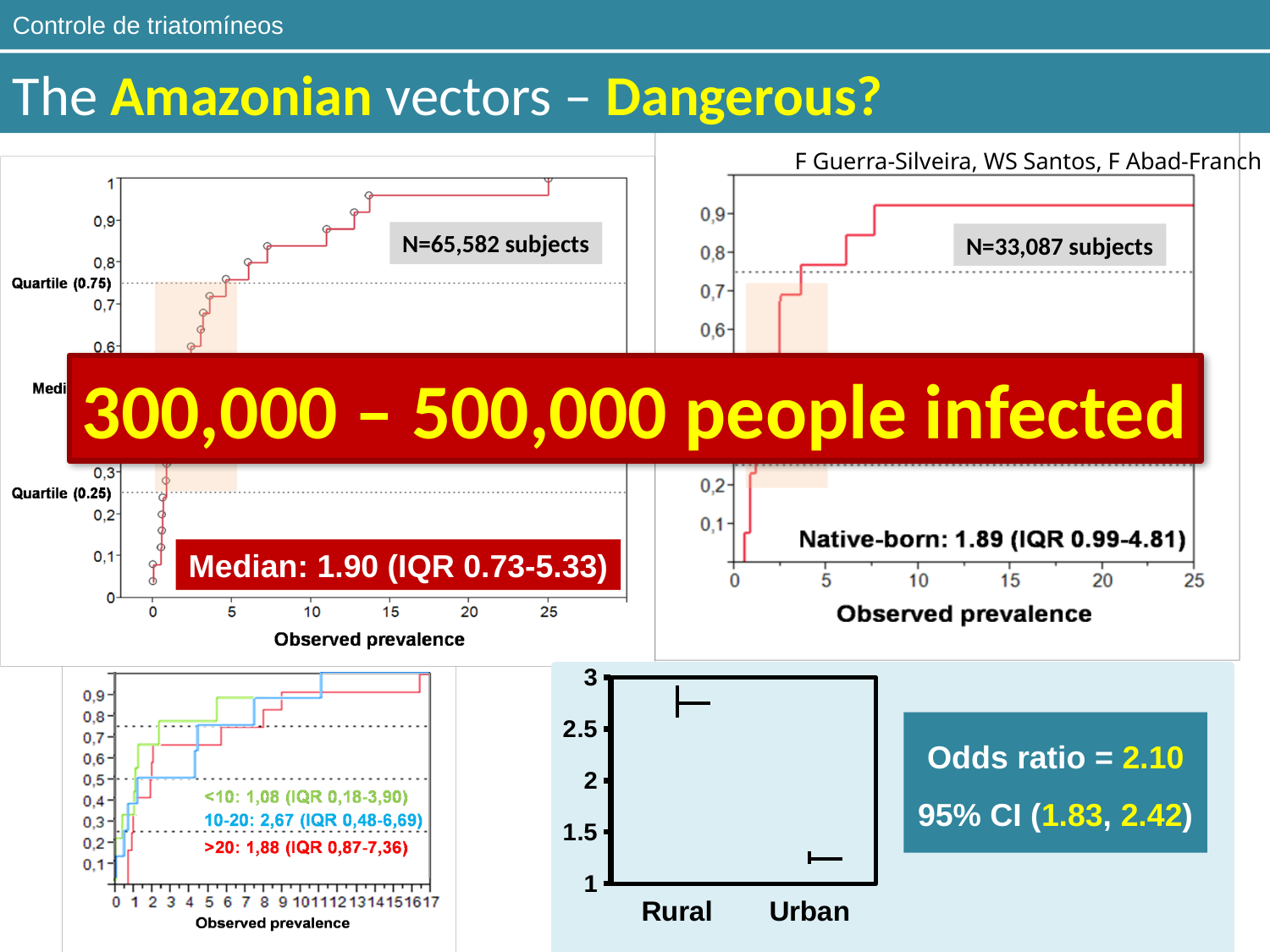
What is the odds ratio reported next to the bottom-right chart? 2.10 In the bottom-right chart, is the value for Rural greater or less than 2.5? greater In the bottom-left chart, how many groups (series) are labelled? 3 In the top-left chart, what is the median observed prevalence reported? 1.90 (IQR 0.73-5.33) In the bottom-right chart, is the value for Urban greater or less than 1.5? less In the top-right chart, what is the native-born median value reported? 1.89 (IQR 0.99-4.81) In the bottom-left chart, what is the value reported for the 10-20 group? 2,67 (IQR 0,48-6,69) In the bottom-right chart, which is larger, the value for Rural or the value for Urban? Rural In the top-right chart, how many subjects are reported (N)? N=33,087 subjects In the top-left chart, how many subjects are reported (N)? N=65,582 subjects In the bottom-left chart, what is the value reported for the <10 group? 1,08 (IQR 0,18-3,90) In the bottom-left chart, which group has the highest reported median value: <10, 10-20 or >20? 10-20